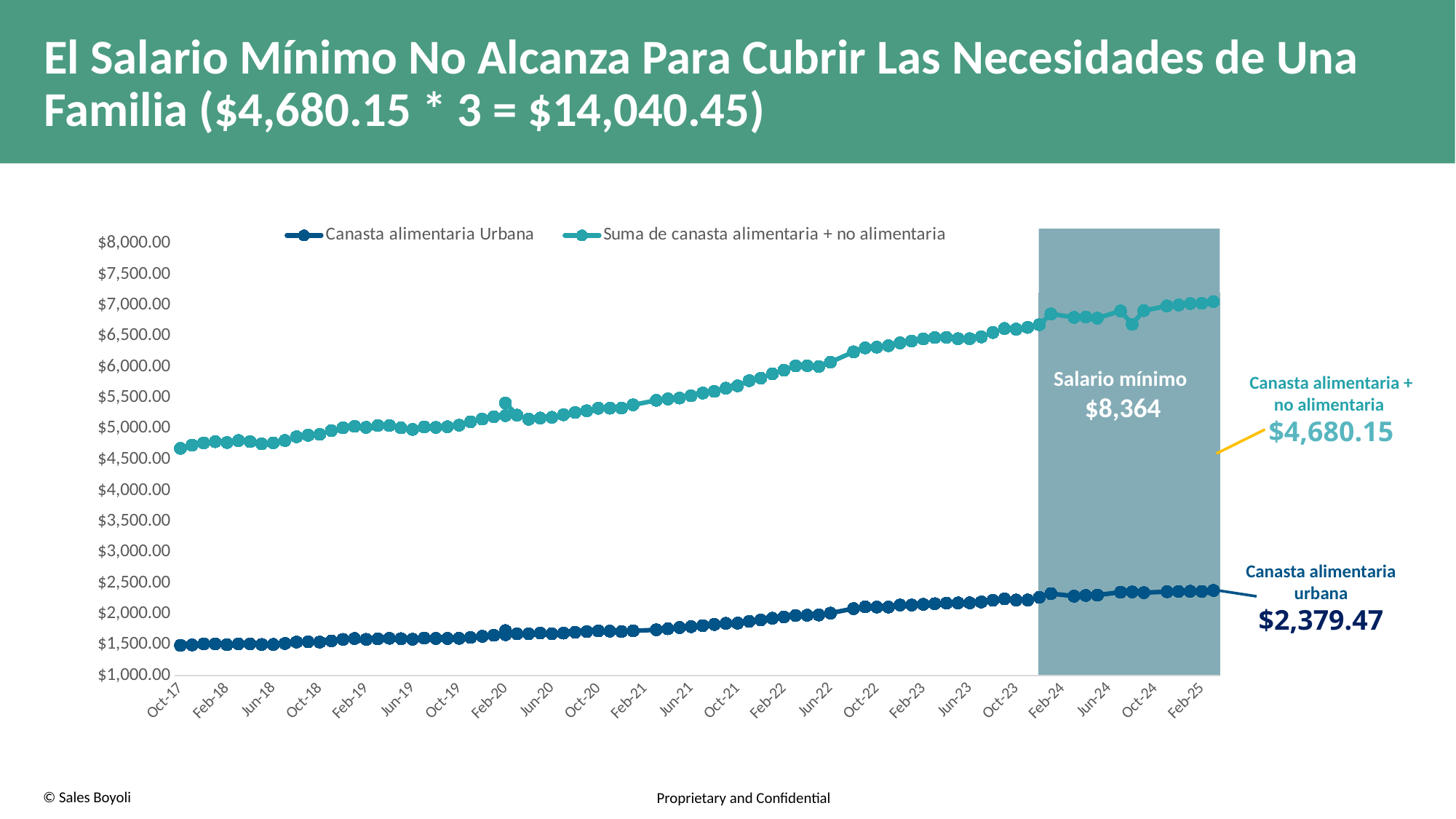
Do the values of Suma de canasta alimentaria + no alimentaria rise or fall from Oct-17 to Feb-25? rise What kind of chart is shown on the slide? line chart What is the latest annotated value for Canasta alimentaria urbana? $2,379.47 Is the value of Suma de canasta alimentaria + no alimentaria at Oct-17 greater or less than $5,000.00? less How many series does the chart legend list? 2 What is the first date label on the x axis of the chart? Oct-17 Is the value of Suma de canasta alimentaria + no alimentaria at Feb-25 greater or less than $6,500.00? greater Is the value of Canasta alimentaria Urbana at Oct-17 greater or less than $2,000.00? less Which series has higher values throughout the chart, Canasta alimentaria Urbana or Suma de canasta alimentaria + no alimentaria? Suma de canasta alimentaria + no alimentaria What value is shown for Salario mínimo in the shaded region of the chart? $8,364 Do the values of Canasta alimentaria Urbana rise or fall from Oct-17 to Feb-25? rise